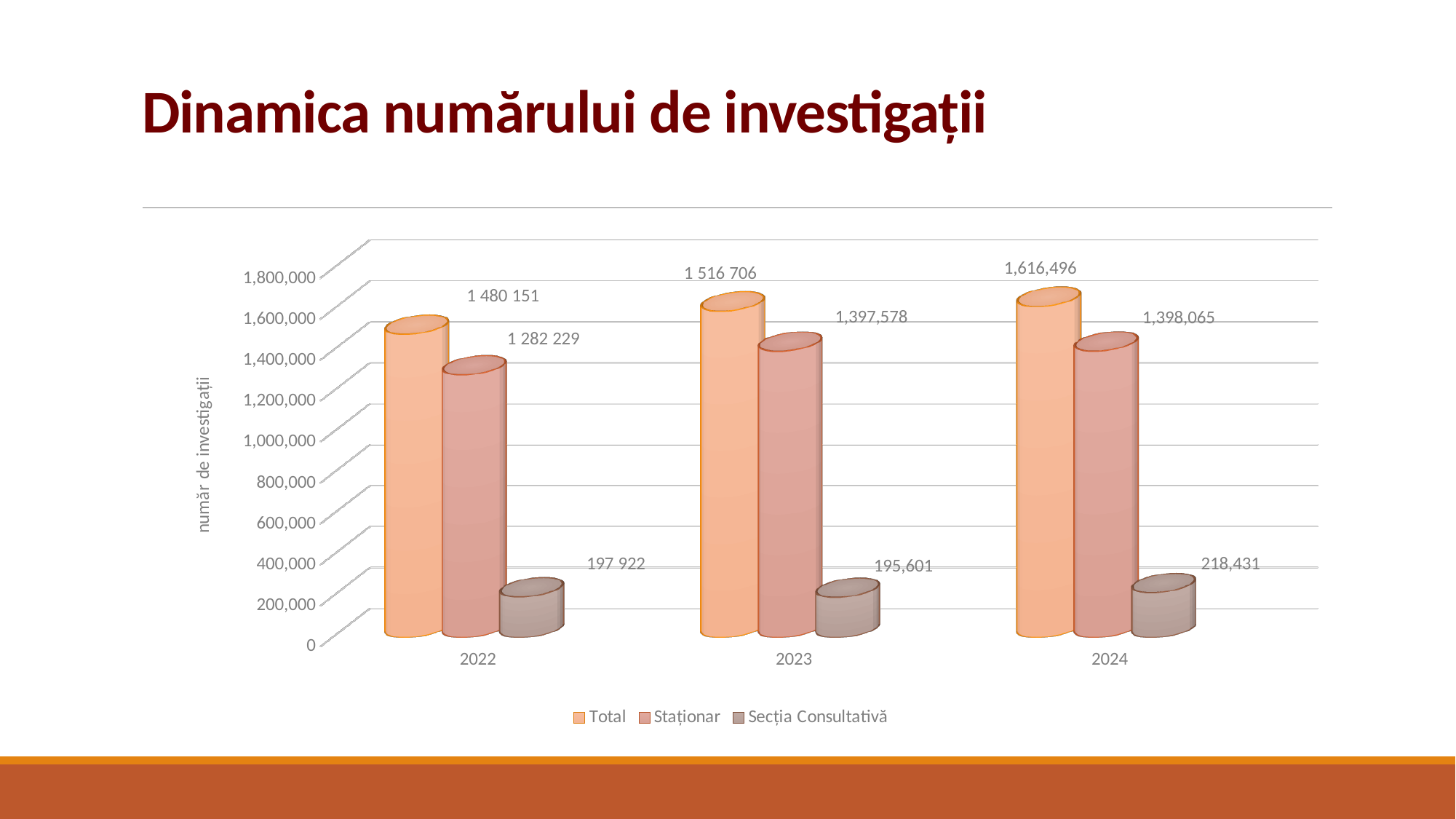
How many series does the legend list? 3 What is the value for Staționar in 2023? 1,397,578 How many years are shown on the x axis? 3 What is the value for Total in 2022? 1 480 151 Which is larger: Staționar in 2022 or Staționar in 2023? Staționar in 2023 In which year is the Secția Consultativă value lowest? 2023 In which year is the Total value highest? 2024 What is the value for Total in 2024? 1,616,496 What is the difference between the Total values for 2024 and 2022? 136,345 Is the value for Secția Consultativă in 2022 greater or less than 400,000? less Does the Total value rise or fall from 2022 to 2024? rise What is the value for Secția Consultativă in 2024? 218,431